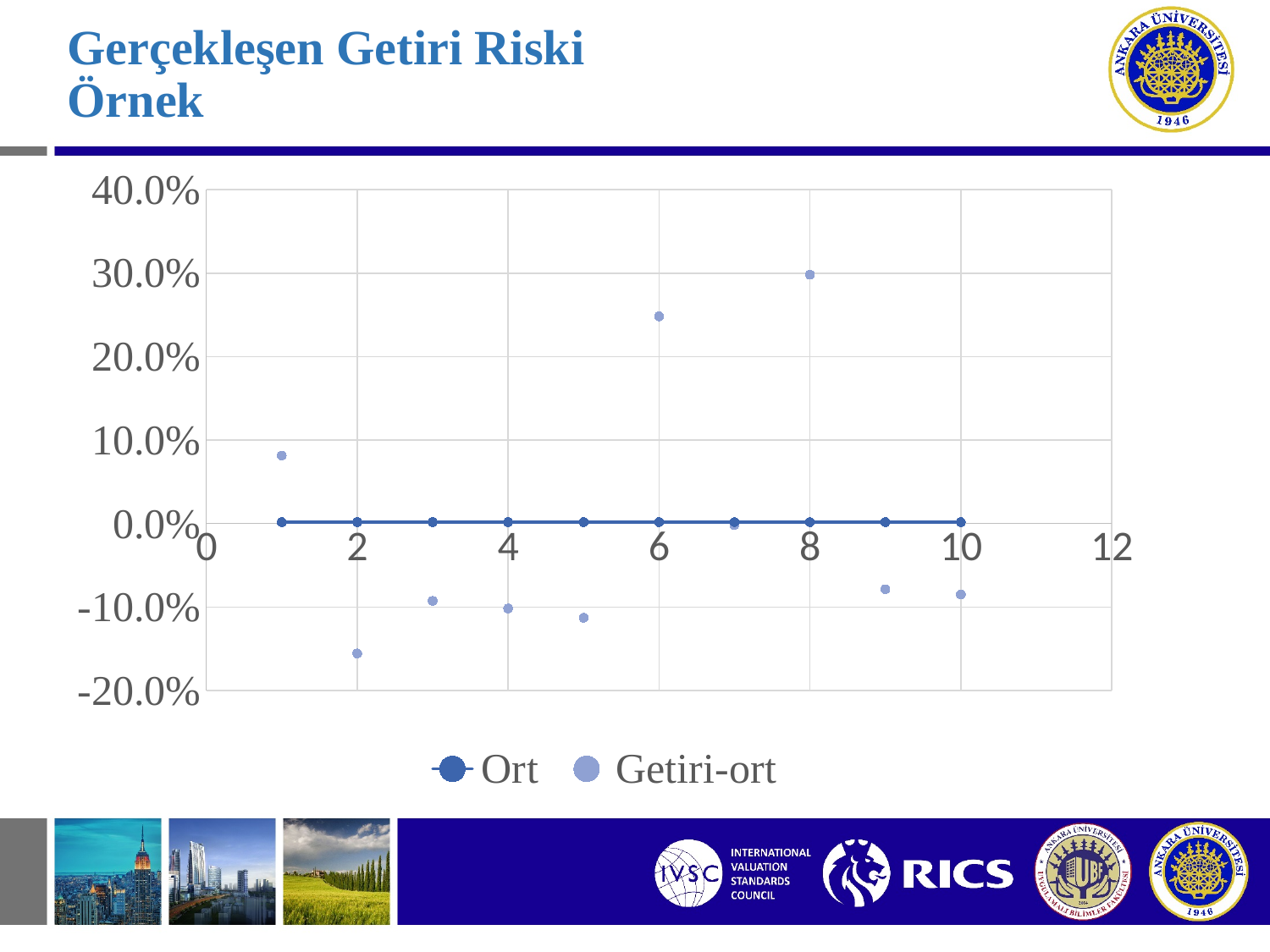
At which x value does the Getiri-ort series reach its lowest point? 2 Which is larger, the Getiri-ort value at x = 6 or at x = 8? x = 8 At which x value does the Getiri-ort series reach its highest point? 8 Is the Getiri-ort value at x = 6 greater or less than 20.0%? greater Is the Getiri-ort value at x = 1 greater or less than 0.0%? greater What are the two series named in the legend? Ort and Getiri-ort What is the highest value shown on the y axis? 40.0% Is the Getiri-ort value at x = 2 greater or less than -10.0%? less What kind of chart is shown on the slide? scatter chart How many points are plotted for the Ort series? 10 How many series does the legend list? 2